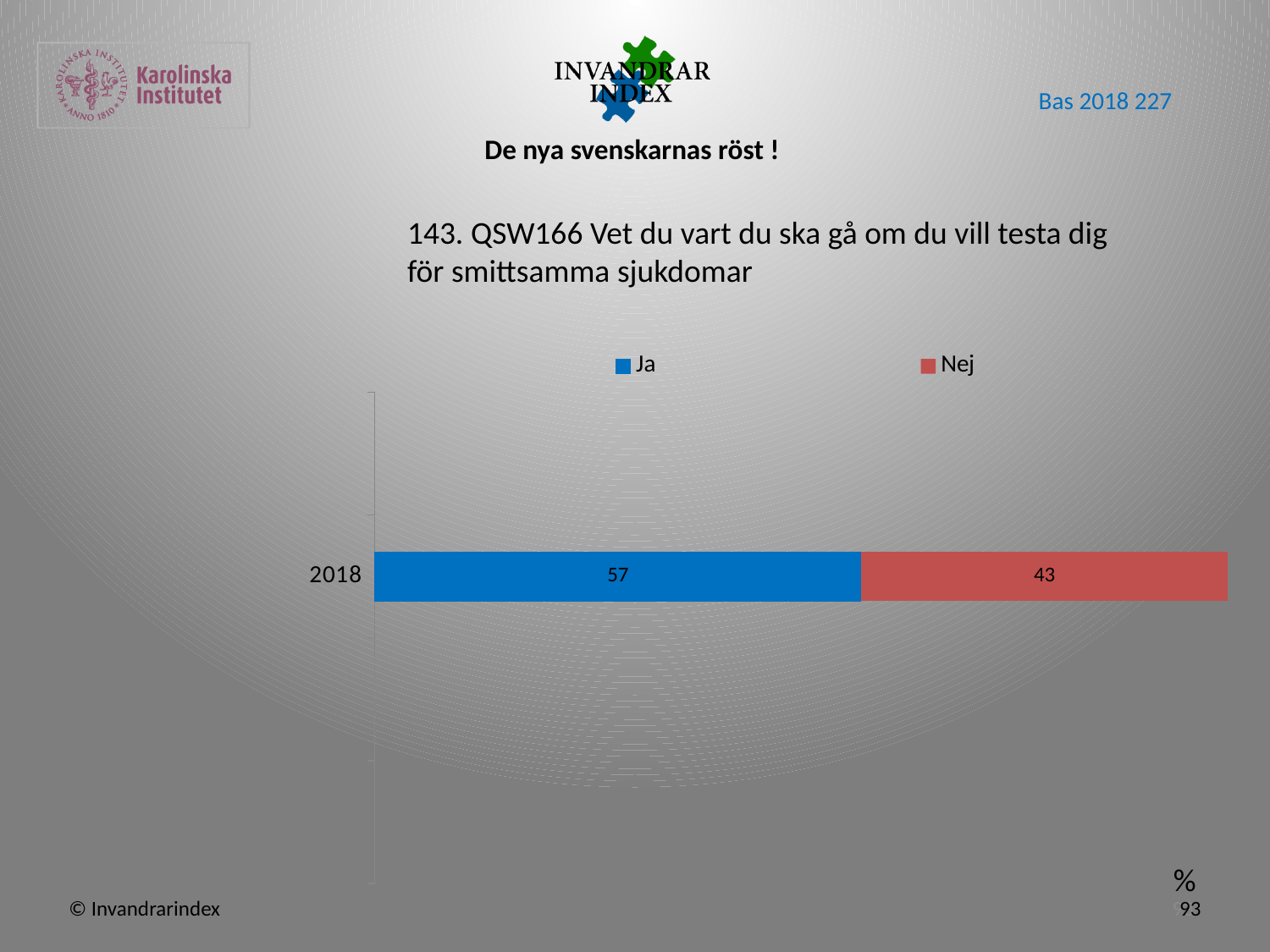
What is the total of the stacked bar for 2018? 100 What colour is the Nej series in the chart? Red What is the value for Nej in 2018? 43 How many series does the legend list? 2 How many categories are shown on the chart? 1 Which year is shown as the category on the chart? 2018 What is the value for Ja in 2018? 57 Which series has the larger value in 2018, Ja or Nej? Ja What kind of chart is shown on the slide? Stacked bar chart What is the difference between the Ja and Nej values in 2018? 14